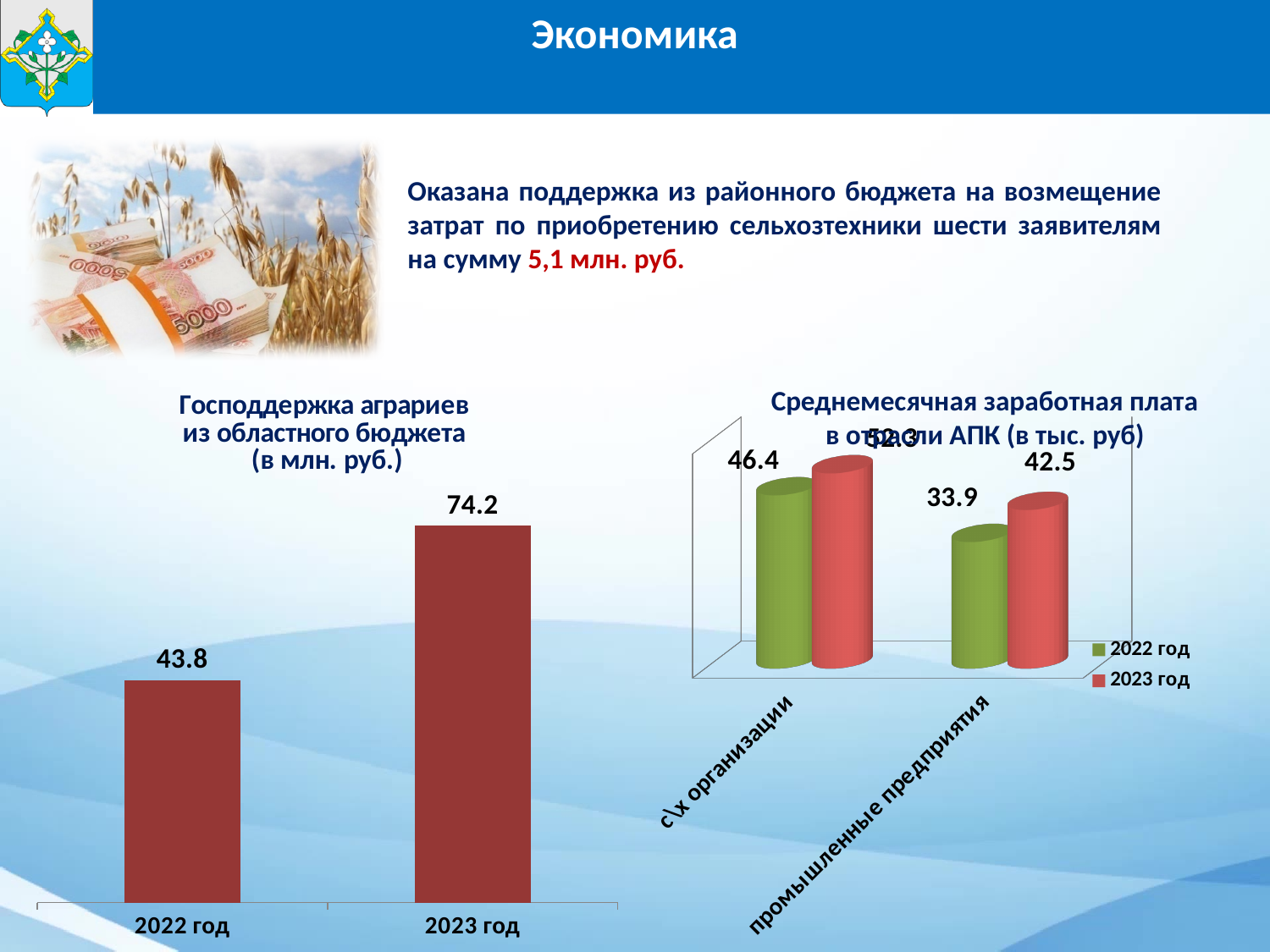
In the left chart 'Господдержка аграриев из областного бюджета', what is the value for 2022 год? 43.8 In the right chart 'Среднемесячная заработная плата в отрасли АПК', what is the 2023 год value for промышленные предприятия? 42.5 In the right chart 'Среднемесячная заработная плата в отрасли АПК', what is the 2022 год value for с\х организации? 46.4 In the left chart 'Господдержка аграриев из областного бюджета', how many categories are shown? 2 What kind of chart is the left chart 'Господдержка аграриев из областного бюджета'? bar chart In the left chart 'Господдержка аграриев из областного бюджета', what is the value for 2023 год? 74.2 In the left chart 'Господдержка аграриев из областного бюджета', do the values rise or fall from 2022 год to 2023 год? rise In the right chart 'Среднемесячная заработная плата в отрасли АПК', which category has the lowest 2022 год value? промышленные предприятия In the right chart 'Среднемесячная заработная плата в отрасли АПК', what is the 2022 год value for промышленные предприятия? 33.9 In the right chart 'Среднемесячная заработная плата в отрасли АПК', what is the difference between the 2023 год and 2022 год values for промышленные предприятия? 8.6 In the right chart 'Среднемесячная заработная плата в отрасли АПК', how many series does the legend list? 2 In the left chart 'Господдержка аграриев из областного бюджета', what is the difference between the 2023 год and 2022 год values? 30.4